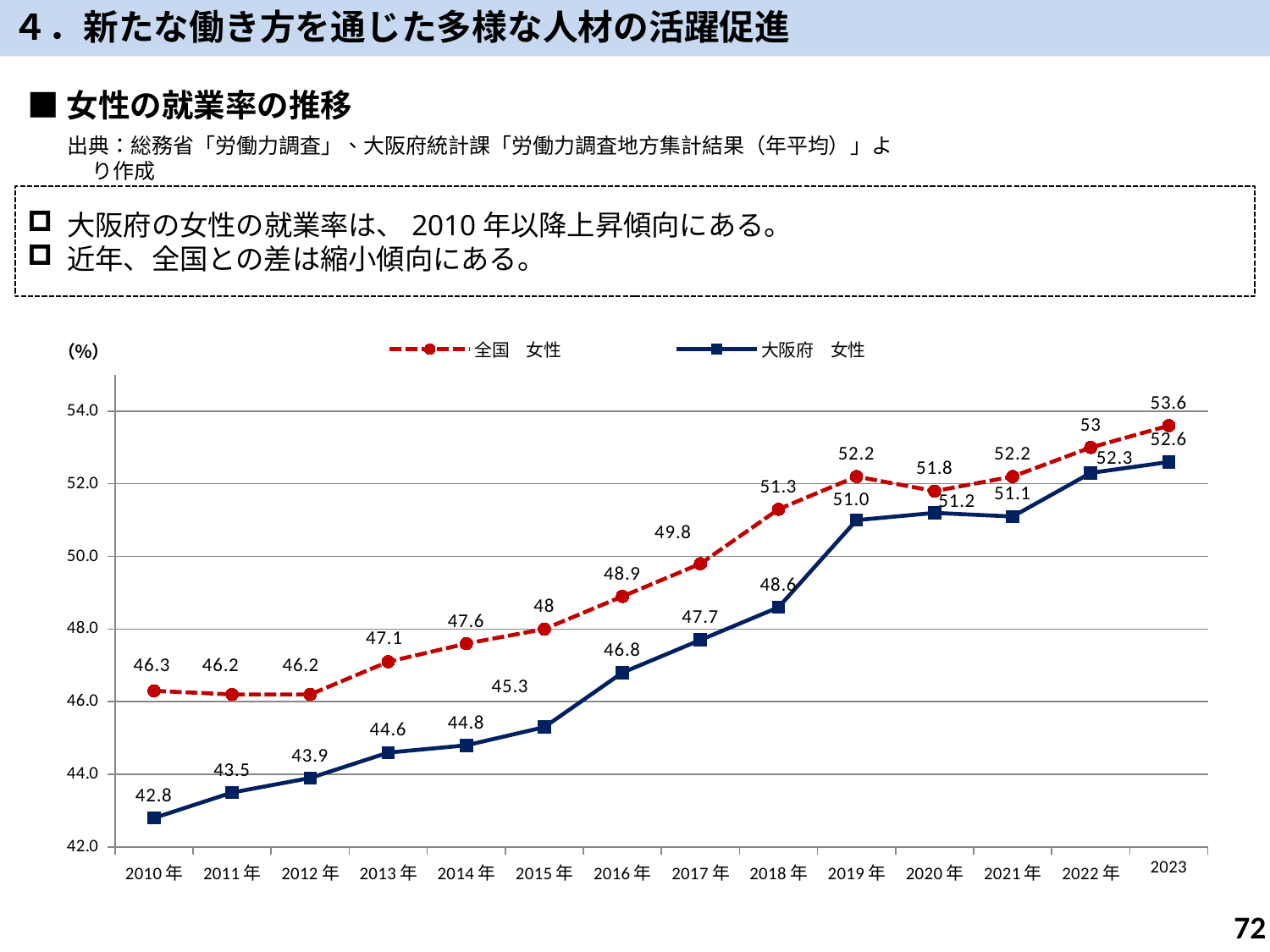
このグラフには何年分のデータ点がありますか？ 14 大阪府 女性の系列で最も値が高いのは何年ですか？ 2023 2020年では全国 女性と大阪府 女性のどちらの値が大きいですか？ 全国 女性 2023年の全国 女性の就業率は何%ですか？ 53.6 これはどの種類のグラフですか？ 折れ線グラフ 大阪府 女性の就業率は2010年から2023年にかけて全体として上昇していますか、下降していますか？ 上昇 2023年の全国 女性と大阪府 女性の差はいくつですか？ 1.0 2019年の大阪府 女性の値はいくつですか？ 51.0 全国 女性の系列で最も値が低いのは何年ですか？ 2011年と2012年（46.2） 2010年の大阪府 女性の就業率は何%ですか？ 42.8 2010年の全国 女性と大阪府 女性の差はいくつですか？ 3.5 凡例にはいくつの系列が示されていますか？ 2